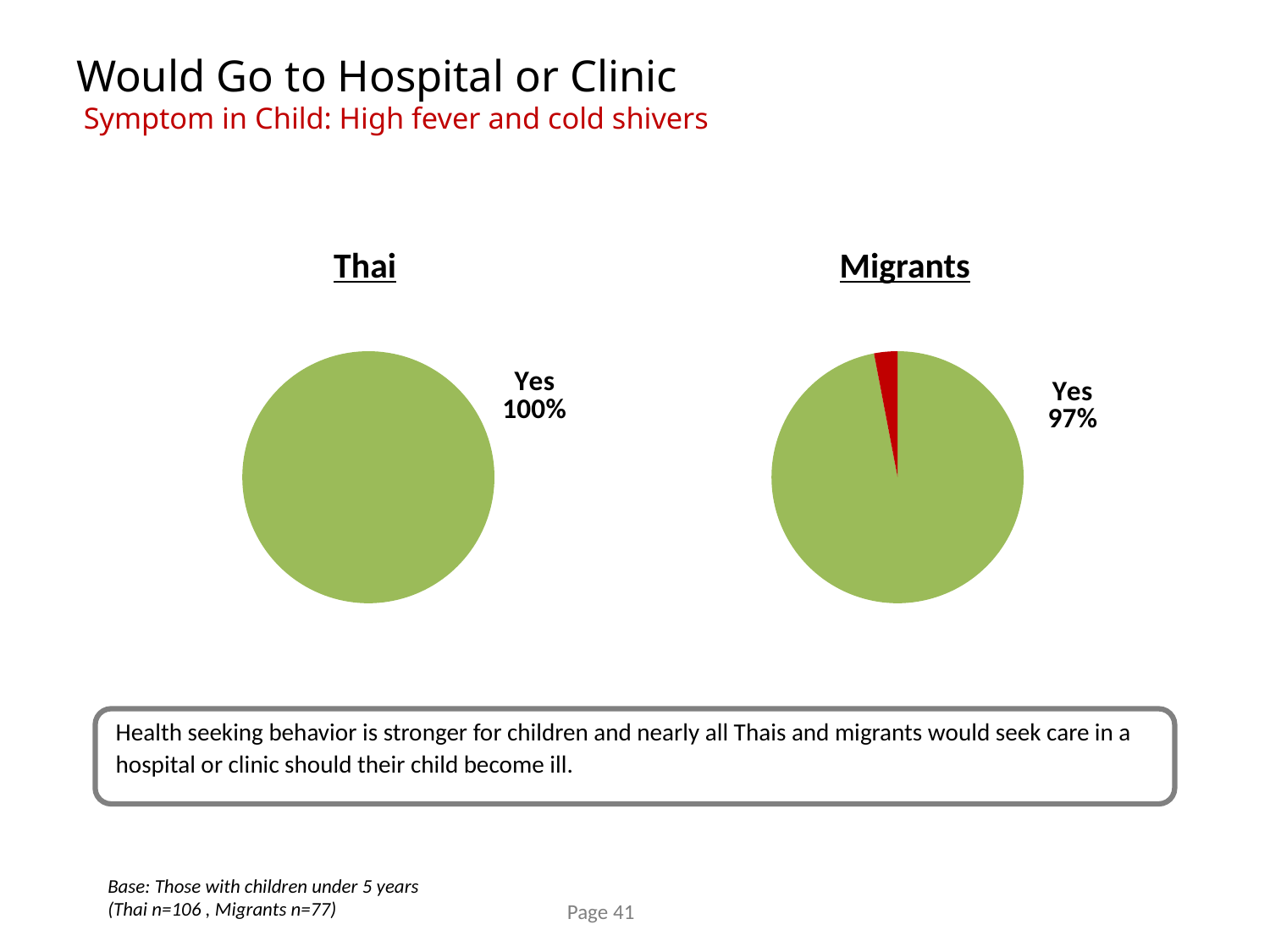
In the Migrants chart, what share of respondents answered Yes? 97% In the Thai chart, what share of respondents answered Yes? 100% In the Migrants chart, what colour is the Yes slice? Green What kind of chart is the Migrants chart? Pie chart What is the title of the slide containing the two pie charts? Would Go to Hospital or Clinic Which group has the higher Yes share, Thai or Migrants? Thai What kind of chart is the Thai chart? Pie chart In the Migrants chart, is the Yes share greater or less than 90%? greater What is the difference between the Thai Yes share and the Migrants Yes share? 3% How many pie charts are shown on the slide? 2 In the Migrants chart, how many slices does the pie have? 2